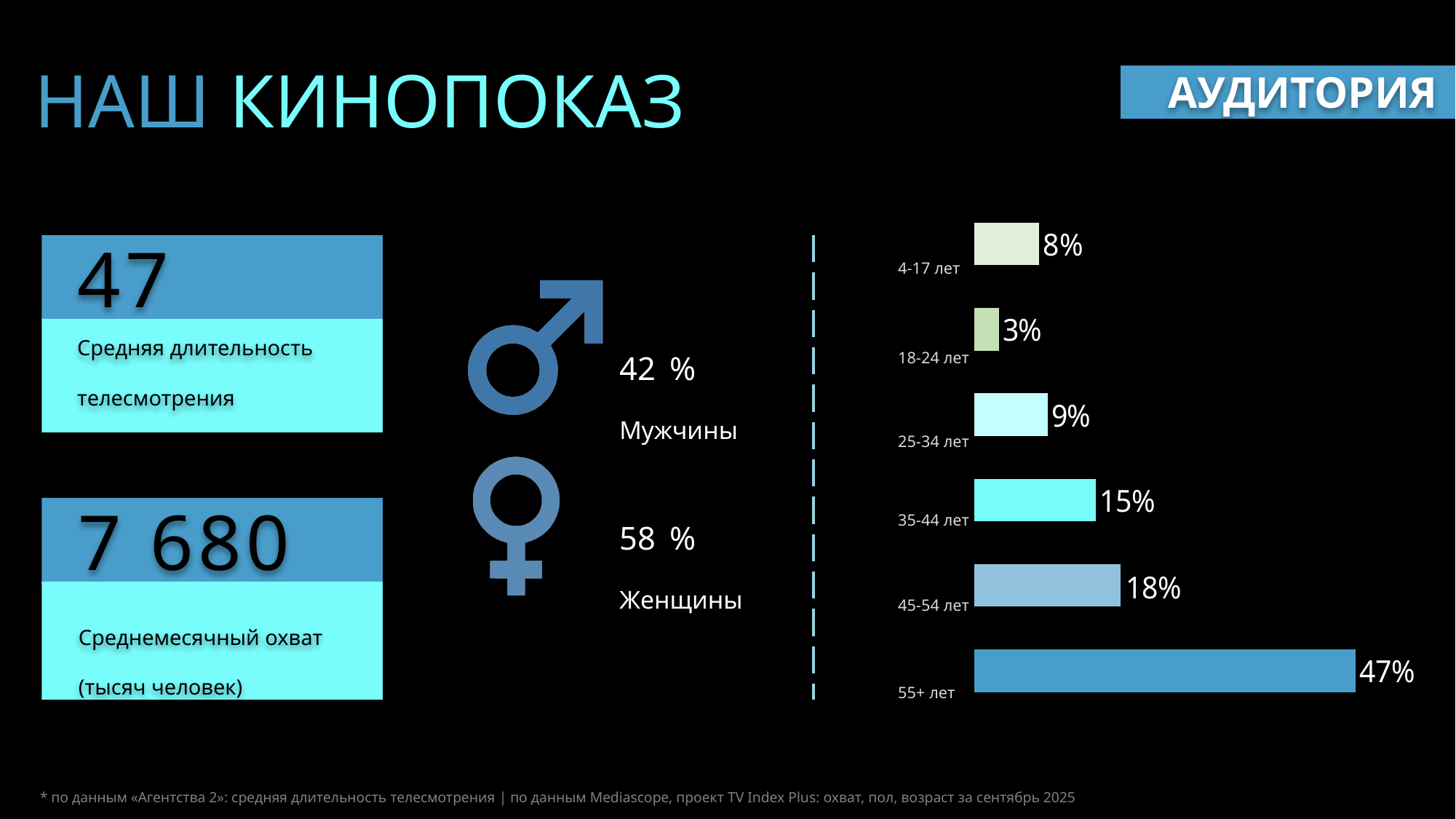
In the bar chart on the right, which is larger: the value for 25-34 лет or the value for 4-17 лет? 25-34 лет In the bar chart on the right, what is the difference between the values for 35-44 лет and 25-34 лет? 6% In the bar chart on the right, do the values generally rise or fall going from the 18-24 лет group down to the 55+ лет group? Rise In the bar chart on the right, which age group has the highest value? 55+ лет What kind of chart is shown on the right side of the slide? Bar chart How many age groups are shown in the bar chart on the right? 6 In the bar chart on the right, what is the value for the 4-17 лет age group? 8% In the bar chart on the right, what is the difference between the values for 55+ лет and 45-54 лет? 29% In the bar chart on the right, what is the value for the 18-24 лет age group? 3% In the bar chart on the right, what is the value for the 35-44 лет age group? 15% In the bar chart on the right, which age group has the lowest value? 18-24 лет In the bar chart on the right, what is the value for the 55+ лет age group? 47%